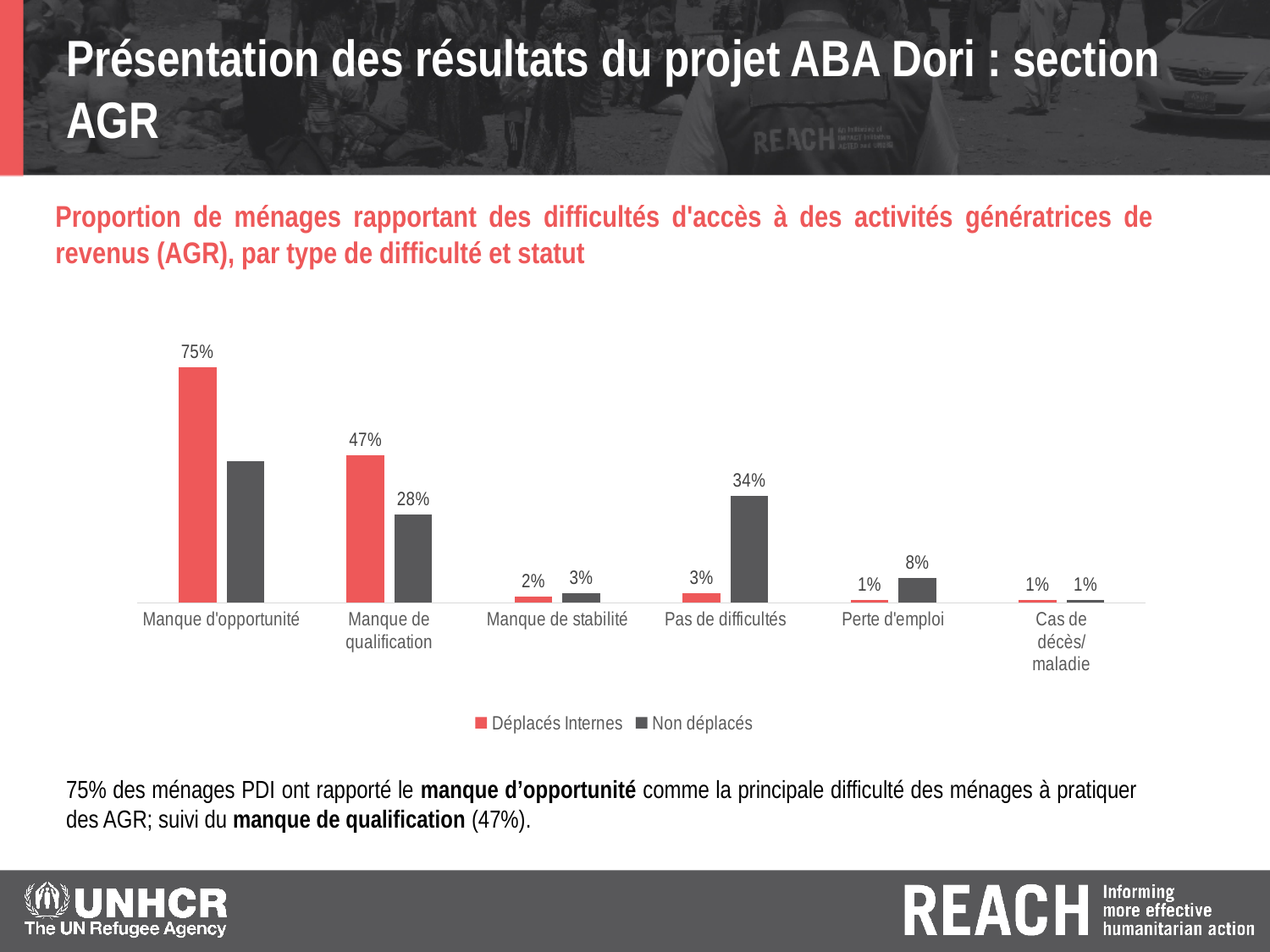
What is the difference between the Déplacés Internes and Non déplacés values for Manque de qualification? 19 percentage points What is the value for Non déplacés in the Manque de qualification category? 28% What is the value for Déplacés Internes in the Perte d'emploi category? 1% Which category has the highest value for Déplacés Internes? Manque d'opportunité What is the value for Non déplacés in the Pas de difficultés category? 34% What type of chart is shown on the slide? Bar chart Which category has the lowest value for Non déplacés? Cas de décès/maladie What percentage of Déplacés Internes households reported Manque d'opportunité? 75% How many difficulty categories are shown on the x axis? 6 Which colour represents the Déplacés Internes series? Red For Pas de difficultés, which series has the larger value, Déplacés Internes or Non déplacés? Non déplacés How many series does the legend list? 2